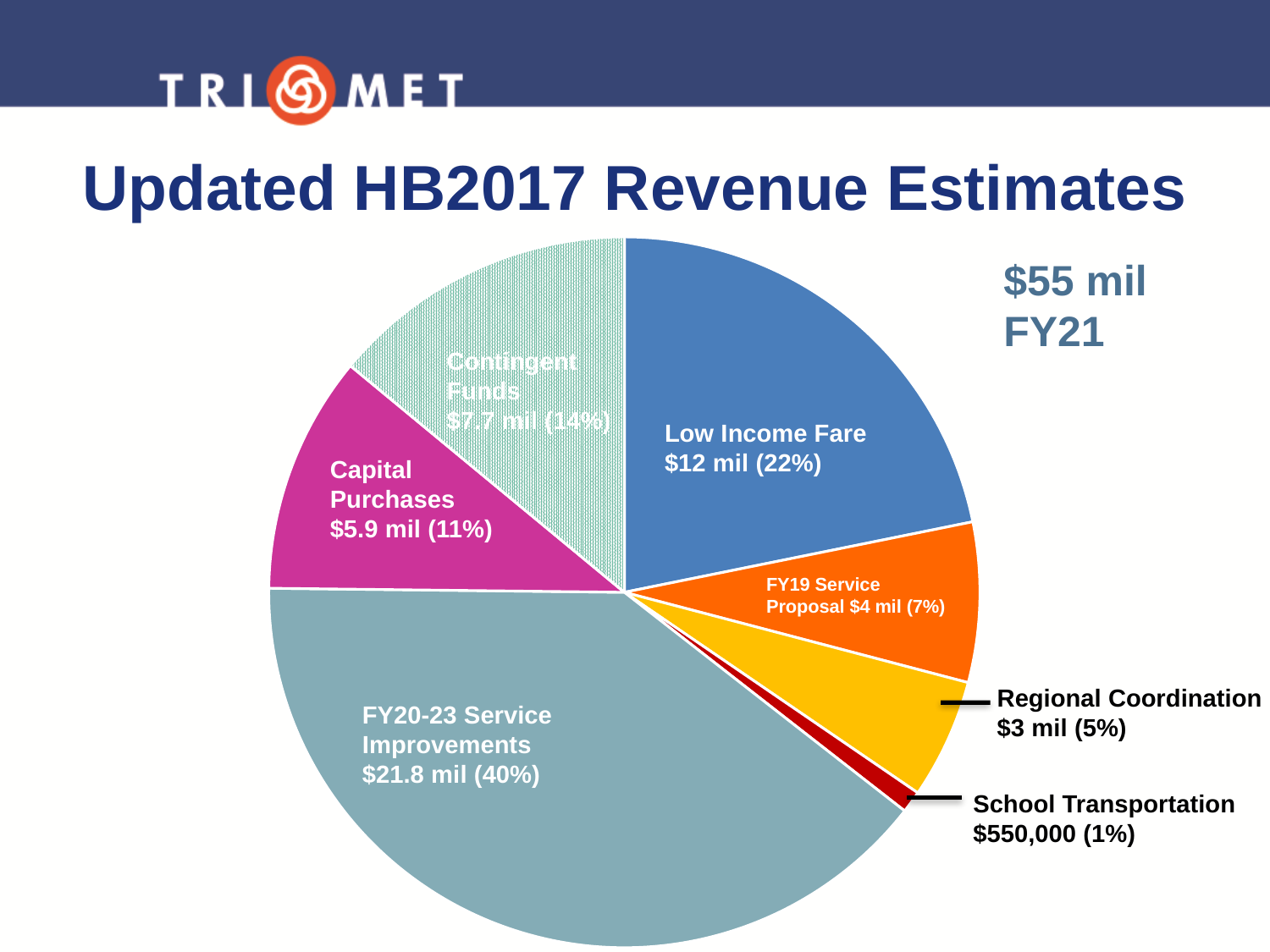
What share of the pie does Contingent Funds represent? 14% How many slices does the pie chart have? 7 Which category has the smallest slice of the pie? School Transportation What is the value shown for Capital Purchases? $5.9 mil (11%) What is the value shown for School Transportation? $550,000 (1%) What share of the pie does Regional Coordination represent? 5% What kind of chart is shown on the slide? Pie chart What is the title of the slide containing the pie chart? Updated HB2017 Revenue Estimates What is the value shown for Low Income Fare? $12 mil (22%) Which is larger, Low Income Fare or Capital Purchases? Low Income Fare Which category has the largest slice of the pie? FY20-23 Service Improvements What is the value shown for FY20-23 Service Improvements? $21.8 mil (40%)